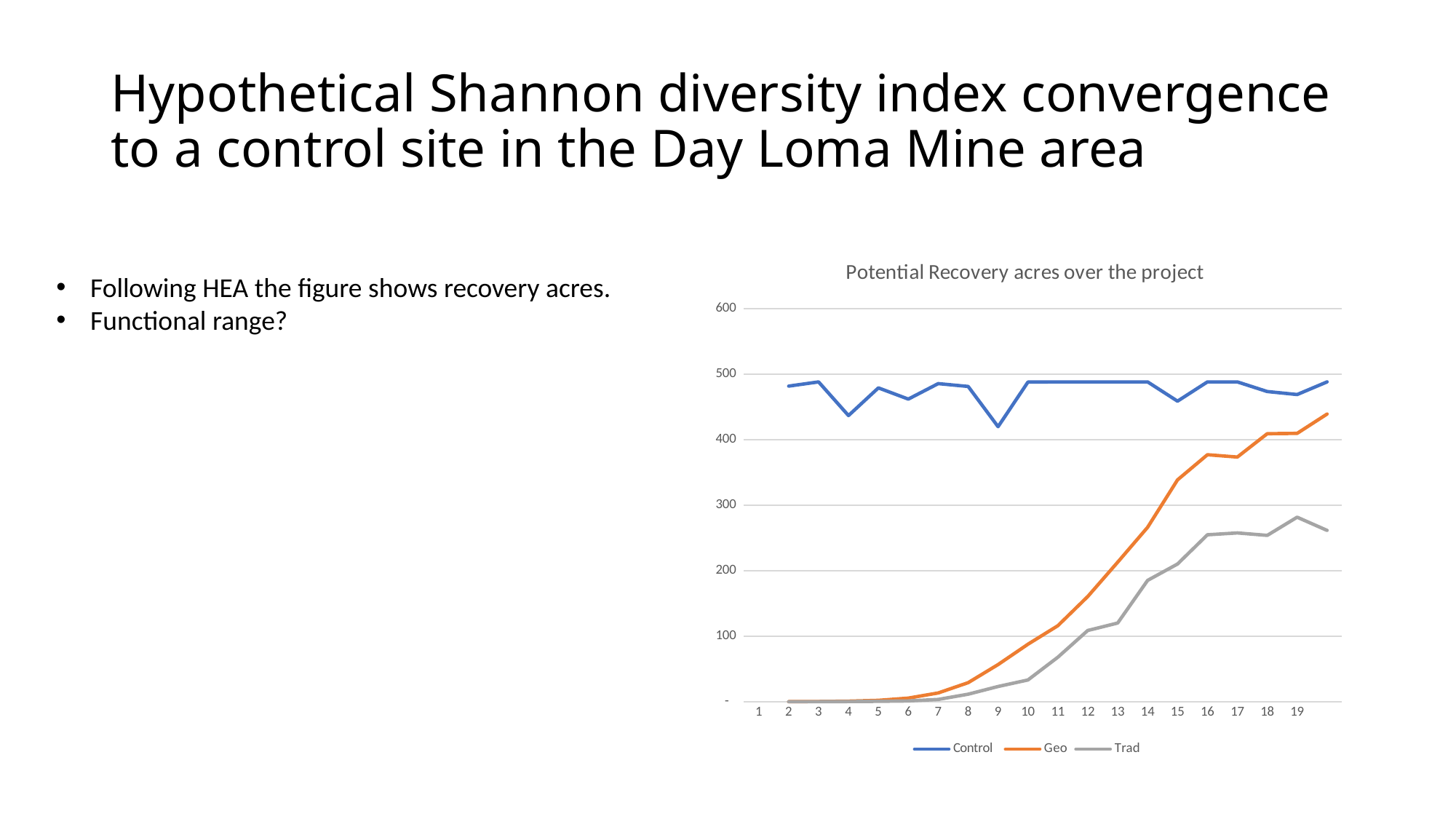
Does the Geo series rise or fall along the x axis overall? rise What is the title of the chart? Potential Recovery acres over the project Is the value for Geo at point 11 greater or less than 200? less Which series is shown in orange in the legend? Geo Is the value for Control at point 10 greater or less than 400? greater Is the value for Geo at point 15 greater or less than 300? greater How many series does the legend list? 3 At point 19, which series has the larger value, Geo or Trad? Geo Which series has the highest value at point 10? Control What kind of chart is shown on the slide? line chart